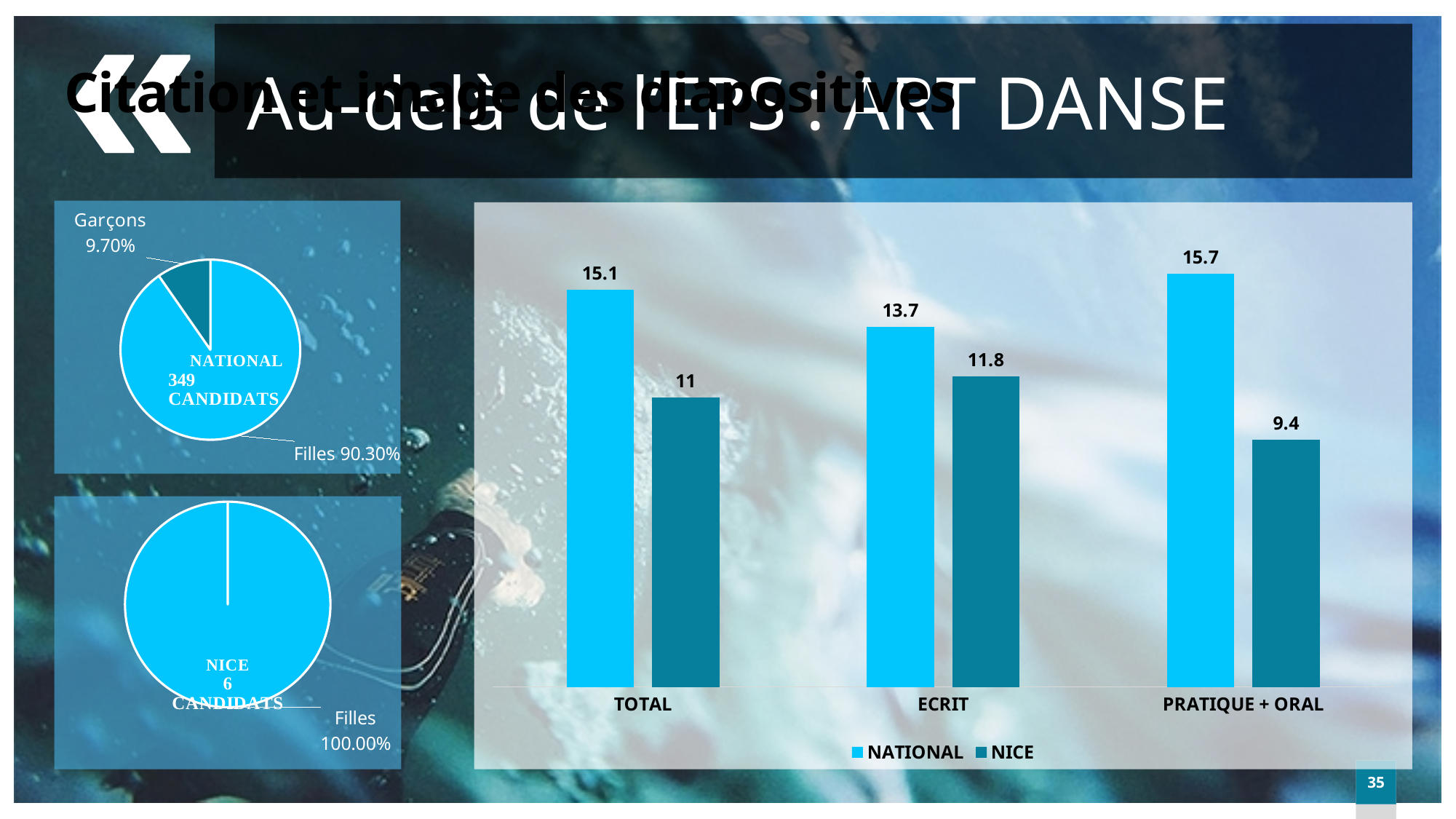
In the bottom-left pie chart (NICE 6 CANDIDATS), what share is Filles? 100.00% In the bar chart on the right, how many series does the legend list? 2 In the bar chart on the right, what is the NATIONAL value for TOTAL? 15.1 In the bar chart on the right, what is the NICE value for ECRIT? 11.8 In the top-left pie chart (NATIONAL 349 CANDIDATS), what share is Garçons? 9.70% In the bar chart on the right, which category has the lowest NICE value? PRATIQUE + ORAL In the bar chart on the right, which category has the highest NATIONAL value? PRATIQUE + ORAL In the bar chart on the right, how many categories are shown on the x axis? 3 What kind of chart is the chart on the right of the slide? Bar chart In the bar chart on the right, what is the difference between the NATIONAL and NICE values for TOTAL? 4.1 In the bar chart on the right, which is larger for ECRIT: NATIONAL or NICE? NATIONAL In the bar chart on the right, what is the NICE value for PRATIQUE + ORAL? 9.4